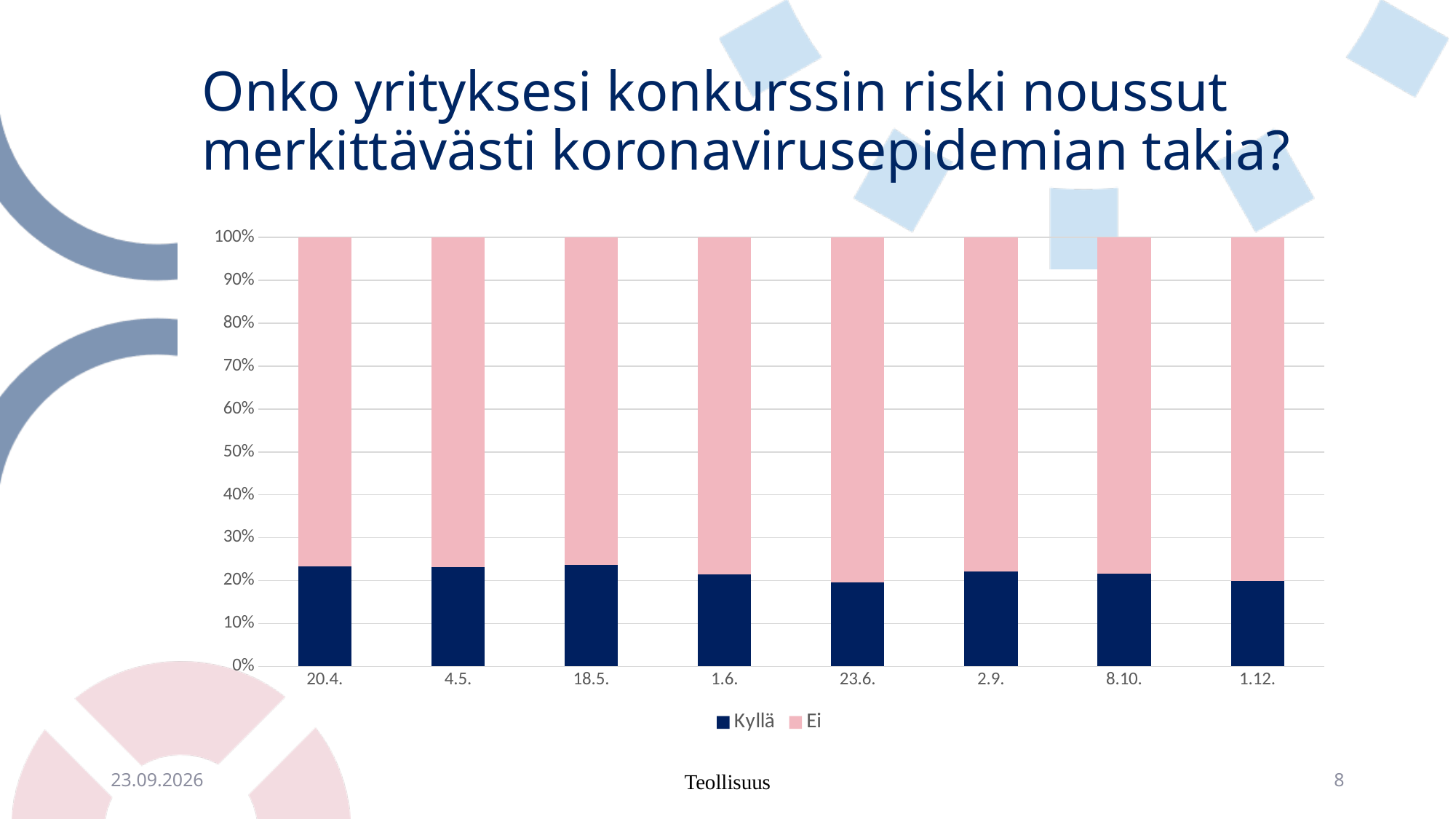
What are the two series named in the chart legend? Kyllä and Ei What kind of chart is shown on the slide? Stacked bar chart Is the 'Kyllä' value for 18.5. greater or less than 30%? less What is the total height of the stacked bar for 20.4.? 100% Is the 'Kyllä' value for 23.6. greater or less than 30%? less Which colour represents the 'Kyllä' series in the chart? Dark blue Is the 'Kyllä' value for 20.4. greater or less than 20%? greater Which has the larger 'Kyllä' share: 20.4. or 1.12.? 20.4. How many series does the chart legend list? 2 How many dates (categories) are shown on the x axis of the chart? 8 Which has the larger 'Kyllä' share: 18.5. or 23.6.? 18.5.